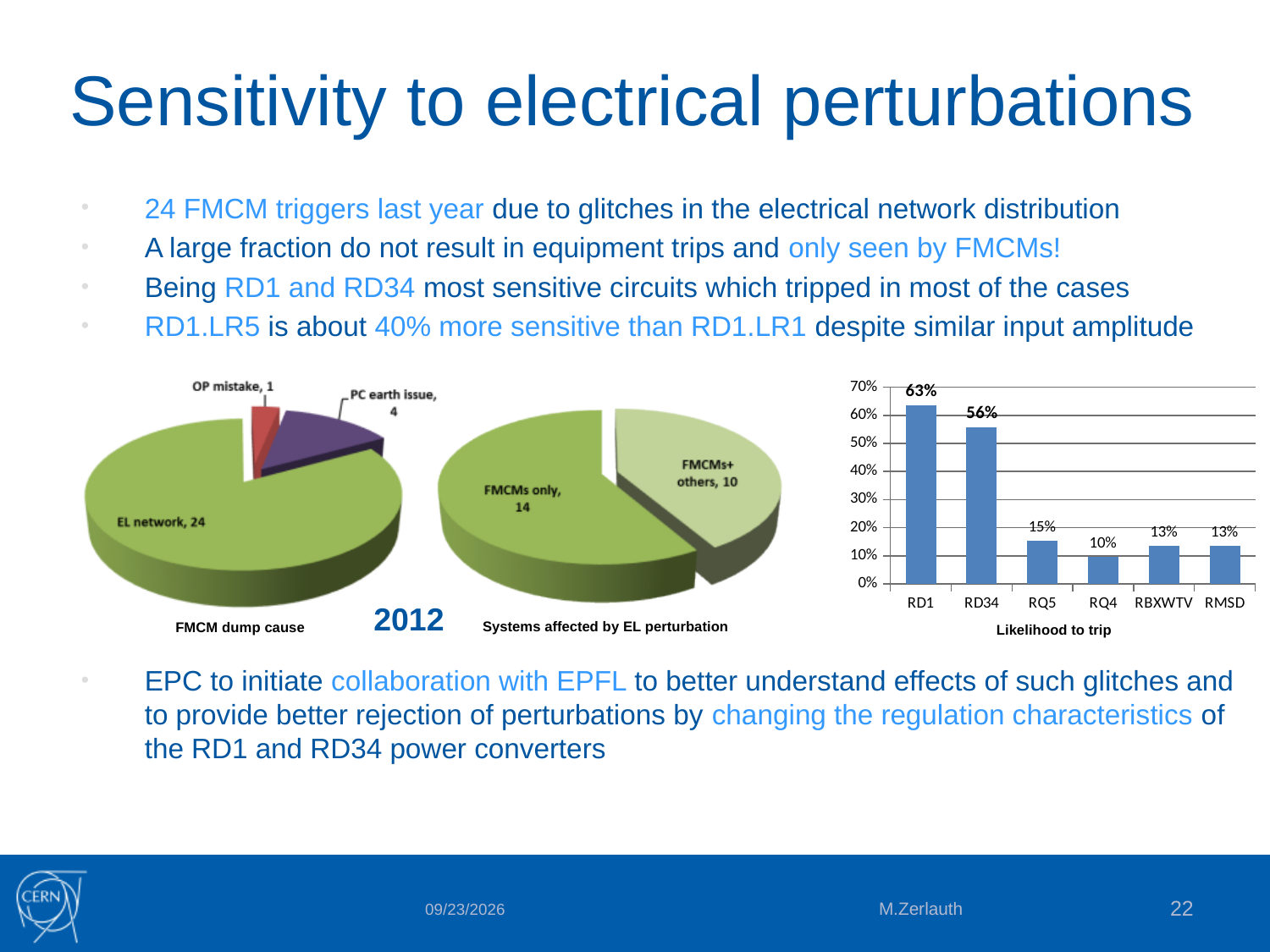
In the 'Systems affected by EL perturbation' pie chart, what is the value for FMCMs only? 14 In the 'Systems affected by EL perturbation' pie chart, what is the difference between FMCMs only and FMCMs+others? 4 In the 'Likelihood to trip' chart, what is the value for RD1? 63% In the 'Likelihood to trip' chart, which category has the lowest value? RQ4 In the 'Likelihood to trip' chart, which is larger, the value for RQ5 or the value for RBXWTV? RQ5 In the 'FMCM dump cause' pie chart, which category has the smallest value? OP mistake What kind of chart is the 'Likelihood to trip' chart? bar chart In the 'Likelihood to trip' chart, what is the value for RQ4? 10% In the 'FMCM dump cause' pie chart, what is the value for EL network? 24 In the 'Likelihood to trip' chart, which category has the highest value? RD1 In the 'Likelihood to trip' chart, what is the difference between the values for RD1 and RD34? 7% In the 'Likelihood to trip' chart, how many categories are shown on the x axis? 6